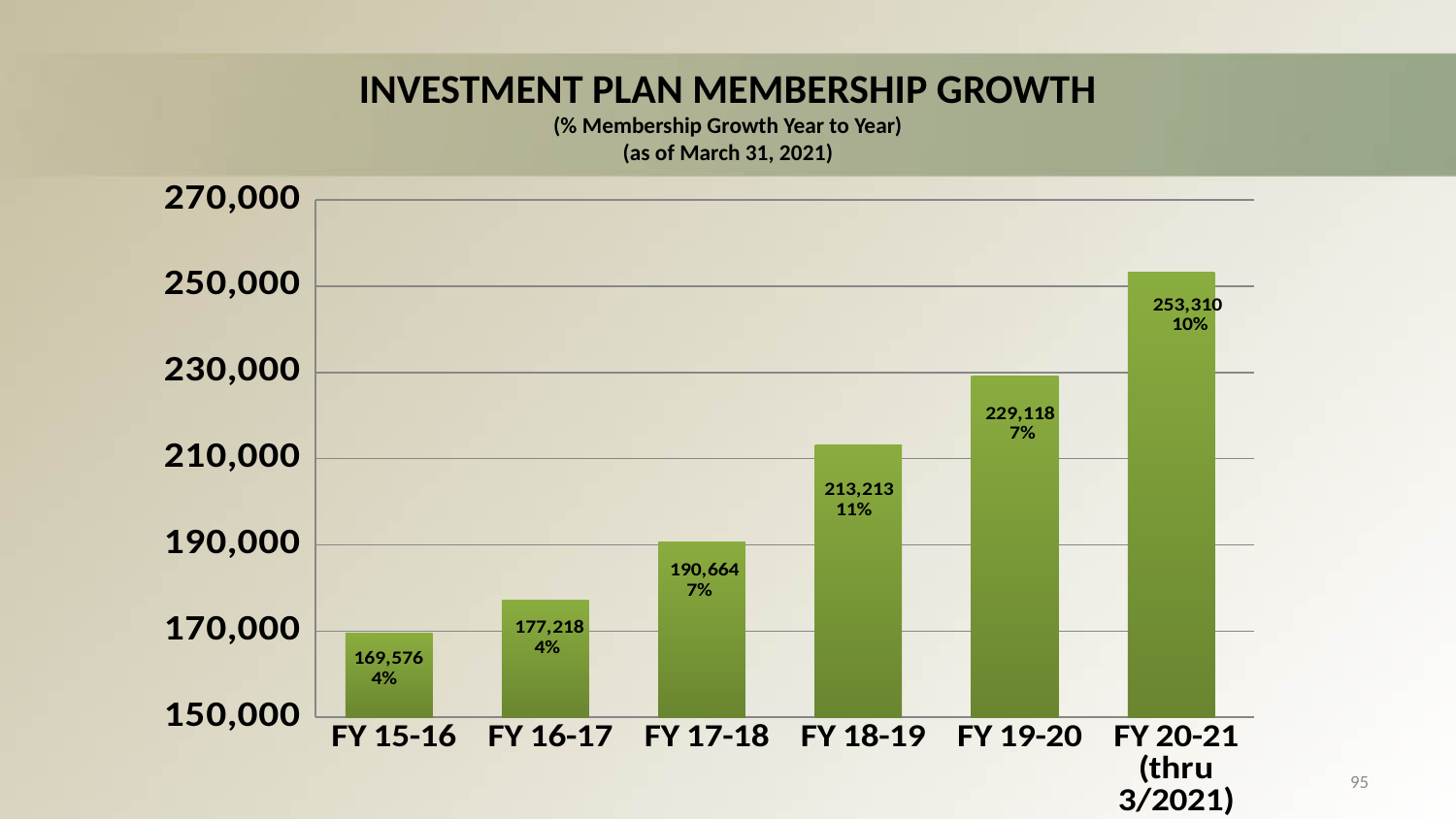
What is the membership value shown for FY 20-21 (thru 3/2021)? 253,310 What is the title of the chart? INVESTMENT PLAN MEMBERSHIP GROWTH Is the membership value for FY 19-20 greater or less than 230,000? less Which fiscal year has the highest membership value? FY 20-21 (thru 3/2021) What is the difference in membership between FY 19-20 and FY 18-19? 15,905 What percentage growth is shown for FY 18-19? 11% Do the membership values rise or fall from FY 15-16 to FY 20-21? rise Which fiscal year has the lowest membership value? FY 15-16 What is the membership value shown for FY 17-18? 190,664 What kind of chart is shown on the slide? bar chart Which is larger, the membership value for FY 16-17 or FY 17-18? FY 17-18 How many fiscal years are shown on the chart? 6